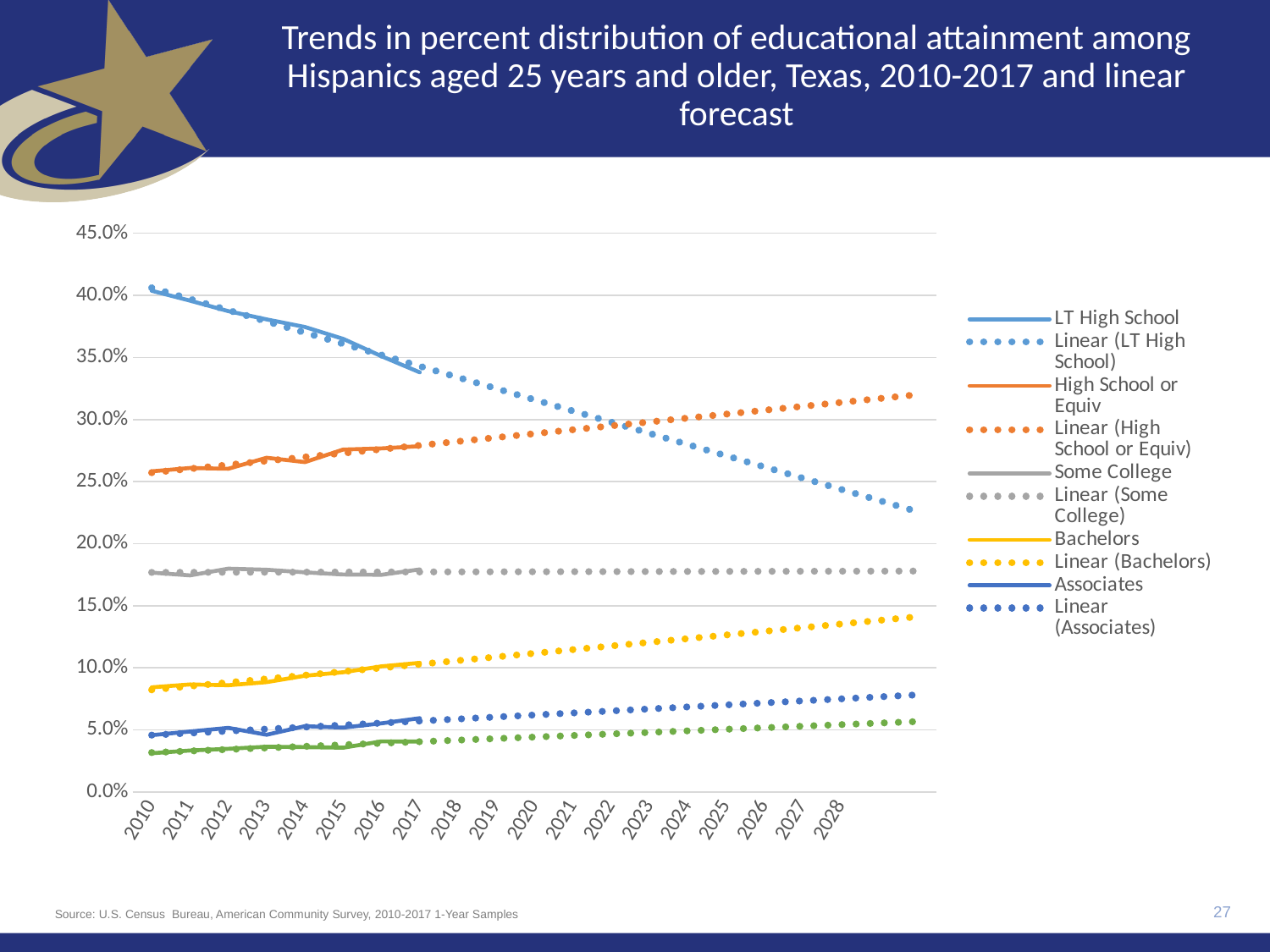
Does the High School or Equiv line rise or fall from 2010 to 2017? Rise Is the value for Some College in 2017 greater or less than 20.0%? less What kind of chart is shown on the slide? Line chart How many entries does the chart legend list? 10 Is the value for High School or Equiv in 2017 greater or less than 25.0%? greater Does the Bachelors line rise or fall from 2010 to 2017? Rise In 2017, which is larger: LT High School or High School or Equiv? LT High School Is the value for LT High School in 2010 greater or less than 35.0%? greater Which series has the highest value in 2010? LT High School How many years are labeled on the x axis? 19 Does the LT High School line rise or fall from 2010 to 2017? Fall